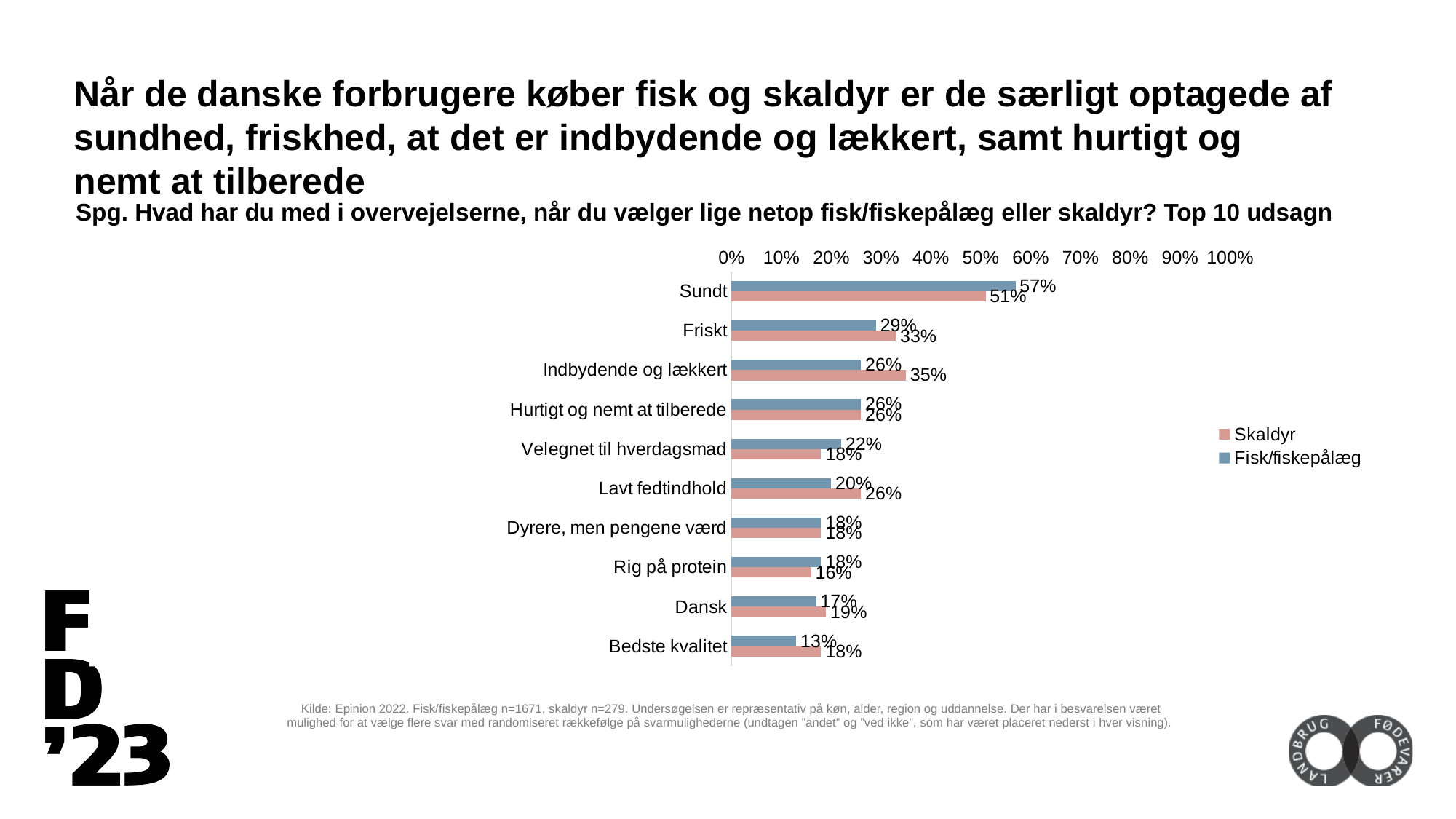
Which category has the highest value in the Skaldyr series? Sundt Is the Fisk/fiskepålæg value for Sundt greater or less than 50%? greater Which colour represents the Skaldyr series in the legend? Pink What is the value for Indbydende og lækkert in the Skaldyr series? 35% What is the value for Sundt in the Fisk/fiskepålæg series? 57% Which category has the lowest value in the Fisk/fiskepålæg series? Bedste kvalitet How many series does the legend list? 2 For Lavt fedtindhold, which series has the larger value, Skaldyr or Fisk/fiskepålæg? Skaldyr What kind of chart is shown on the slide? Bar chart What is the difference between the Fisk/fiskepålæg and Skaldyr values for Sundt? 6 percentage points What is the value for Bedste kvalitet in the Fisk/fiskepålæg series? 13% How many categories are shown on the chart? 10